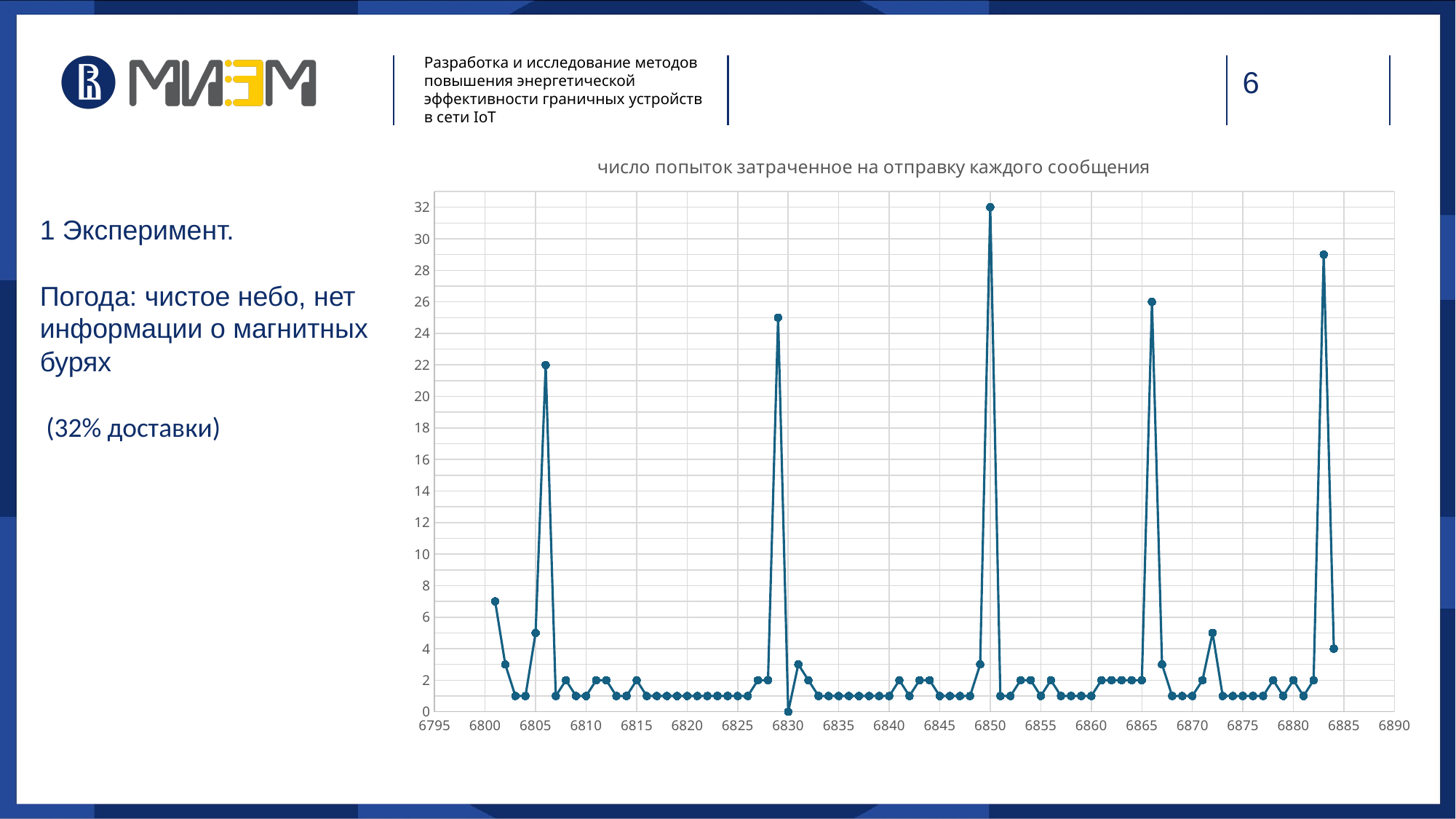
At which x-axis value does the chart reach its maximum? 6850 What is the value at x = 6850? 32 Is the value at x = 6805 greater or less than 4? greater What is the title of the chart? число попыток затраченное на отправку каждого сообщения Which is larger: the peak near x = 6850 or the peak near x = 6806? the peak near 6850 What is the value at x = 6830? 0 Is the value at x = 6820 greater or less than 2? less Is the value at x = 6850 greater or less than 30? greater What is the highest value reached on the chart? 32 How many peaks on the chart exceed 20? 5 What kind of chart is shown on the slide? line chart